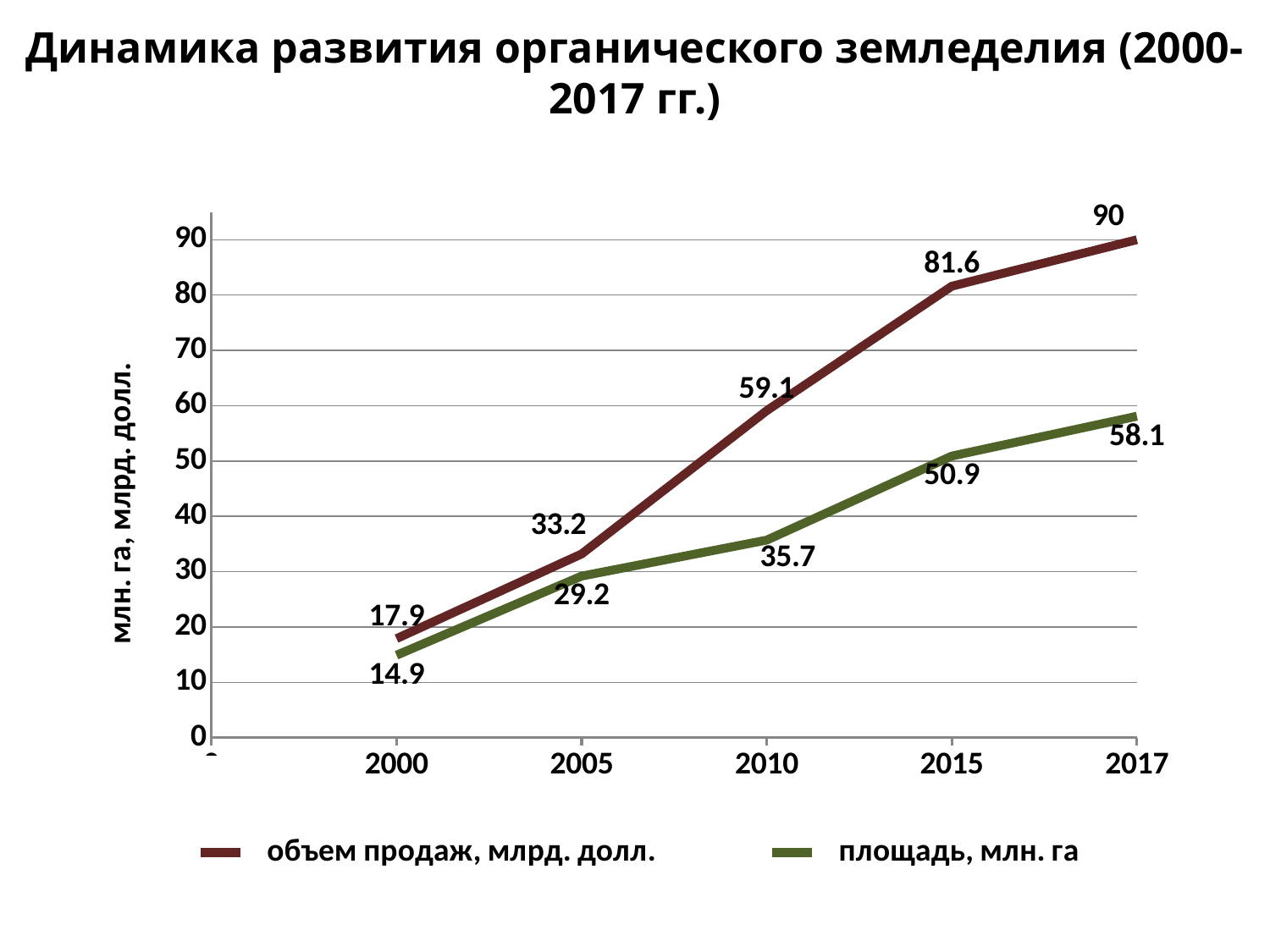
What is the value of площадь, млн. га in 2017? 58.1 In which year is площадь, млн. га lowest? 2000 In which year is объем продаж, млрд. долл. highest? 2017 How many years are plotted on the x axis? 5 What is the difference between объем продаж, млрд. долл. and площадь, млн. га in 2015? 30.7 What is the value of объем продаж, млрд. долл. in 2010? 59.1 What is the title of the chart? Динамика развития органического земледелия (2000-2017 гг.) Does объем продаж, млрд. долл. rise or fall from 2000 to 2017? rise How many series does the legend list? 2 Which is larger in 2000: объем продаж, млрд. долл. or площадь, млн. га? объем продаж, млрд. долл. What type of chart is shown on the slide? line chart What is the value of площадь, млн. га in 2005? 29.2